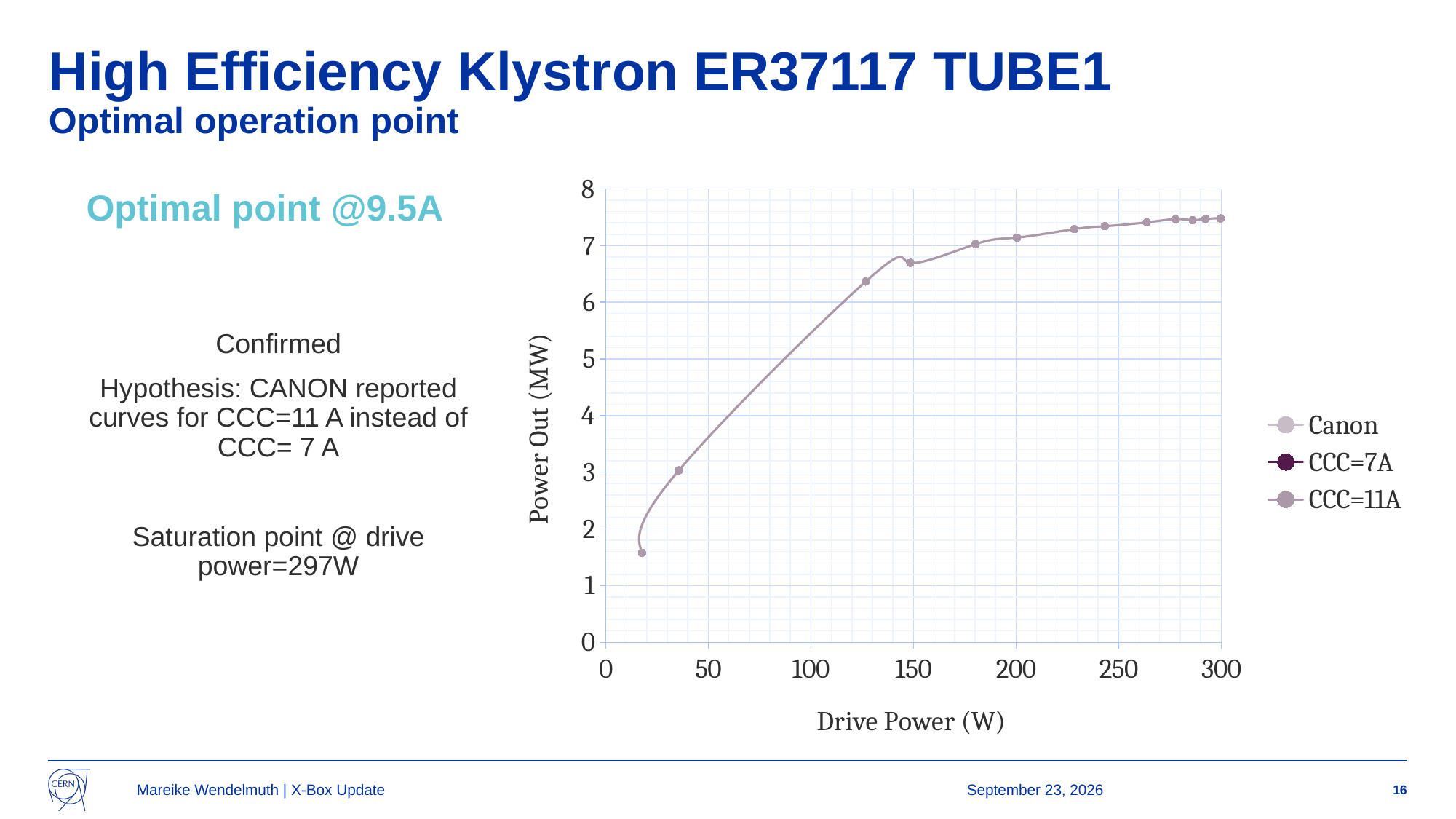
Is the power output at a drive power of about 150 W greater or less than 7? less What kind of chart is shown on the slide? line chart Is the power output at a drive power of about 200 W greater or less than 7? greater Is the power output at a drive power of 300 W greater or less than 7? greater What is the label of the y axis? Power Out (MW) Is the power output higher at a drive power of 300 W or at a drive power of about 35 W? 300 W Does the plotted power output rise or fall as drive power increases along the x axis? rise How many series does the legend list? 3 What are the series names listed in the legend? Canon, CCC=7A, CCC=11A